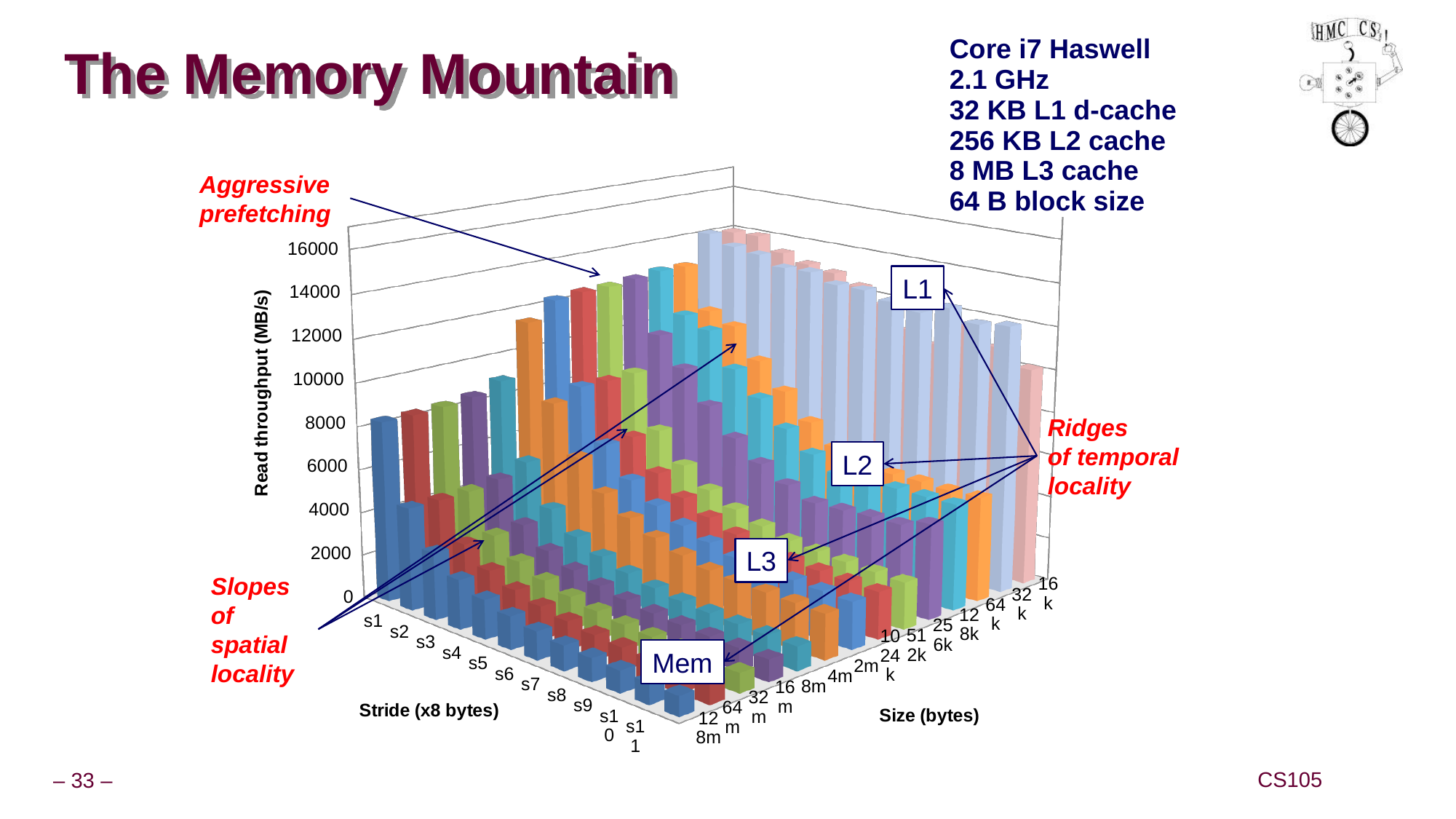
How many stride categories are shown along the Stride (x8 bytes) axis? 11 Is the read throughput for stride s11 at size 128m greater or less than 4000? less Is the read throughput for stride s1 at size 128m greater or less than 4000? greater For stride s1, does read throughput rise or fall as the size goes from 128m toward 16k? rise For a fixed size, does read throughput rise or fall as the stride increases from s1 to s11? fall What is the title of the slide containing the chart? The Memory Mountain Is the read throughput for stride s1 at size 128m greater or less than 12000? less What is the label of the vertical axis of the chart? Read throughput (MB/s) What is the highest tick value shown on the Read throughput (MB/s) axis? 16000 What kind of chart is shown on the slide? 3D bar chart Which is larger: the read throughput for stride s1 at size 16k or for stride s11 at size 128m? stride s1 at size 16k Which stride value has the highest read throughput overall? s1